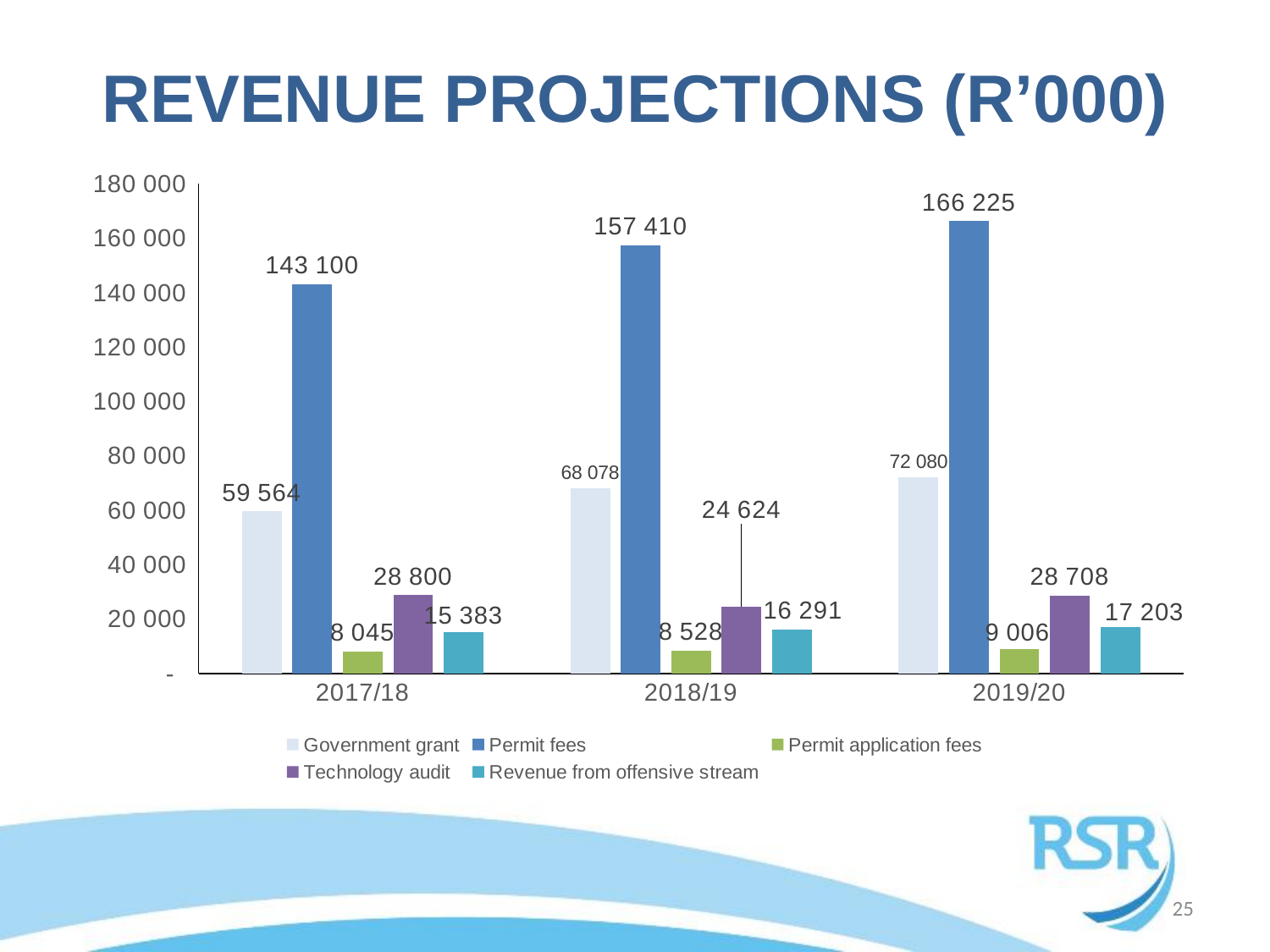
Which series has the lowest value in 2017/18? Permit application fees Which is larger: Government grant in 2019/20 or Technology audit in 2019/20? Government grant in 2019/20 What is the value for Government grant in 2017/18? 59 564 What is the value for Permit fees in 2019/20? 166 225 Is the value for Permit fees in 2017/18 greater or less than 140 000? greater What is the value for Technology audit in 2018/19? 24 624 What is the difference between Permit fees in 2019/20 and Permit fees in 2018/19? 8 815 What is the value for Revenue from offensive stream in 2019/20? 17 203 Do the Permit fees values rise or fall from 2017/18 to 2019/20? rise Which series has the highest value in 2018/19? Permit fees How many year categories are shown on the x axis? 3 How many series does the legend list? 5